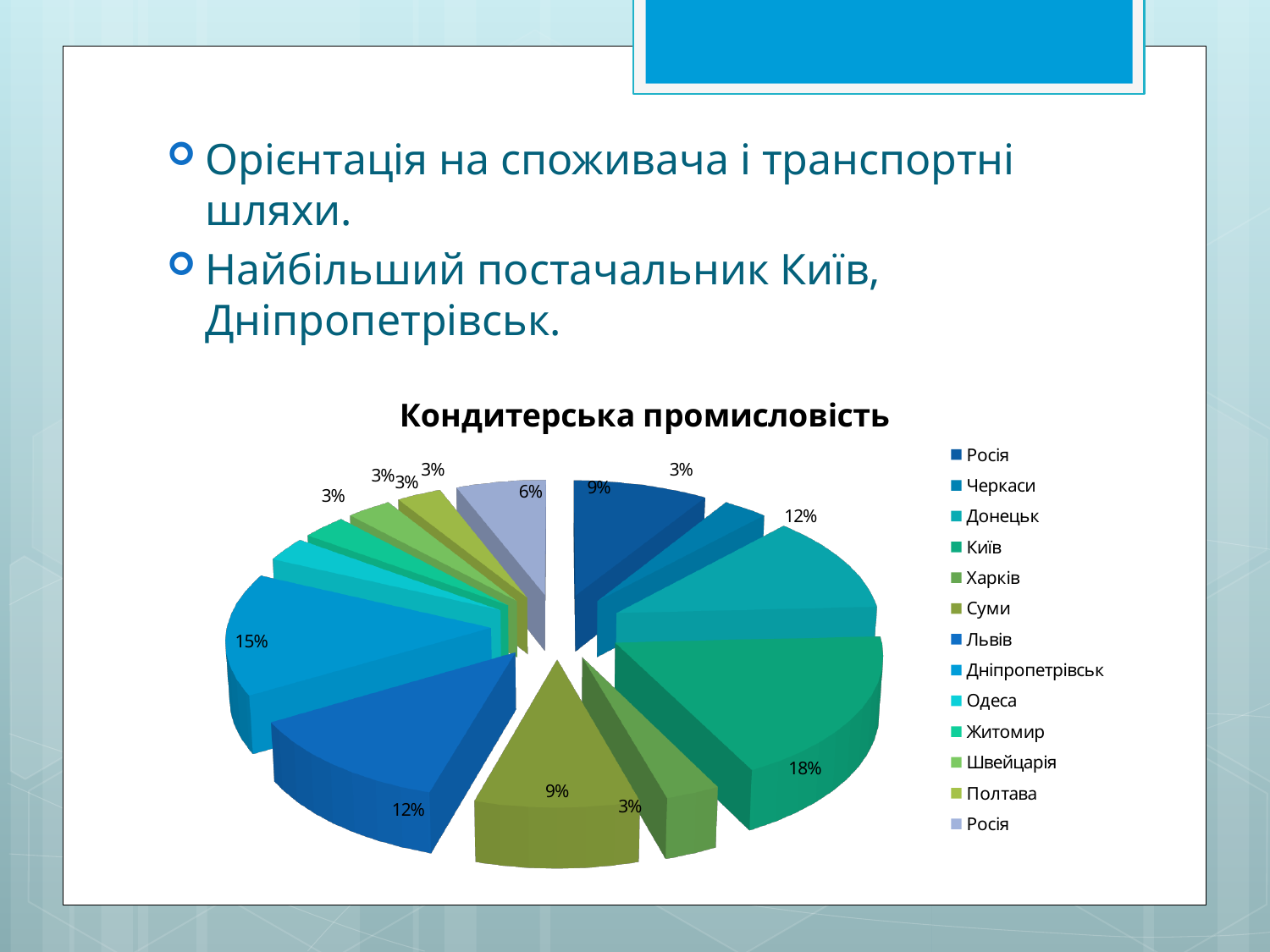
Which has the larger share, Київ or Донецьк? Київ Which has the larger share, Дніпропетровськ or Суми? Дніпропетровськ What share of the pie does Дніпропетровськ have? 15% Which category has the largest share of the pie? Київ How many entries does the chart legend list? 13 What is the difference in percentage points between the shares of Київ and Дніпропетровськ? 3 percentage points How many slices does the pie chart have? 13 What is the title of the chart? Кондитерська промисловість What share of the pie does Донецьк have? 12% What kind of chart is shown on the slide? pie chart What share of the pie does Київ have? 18%